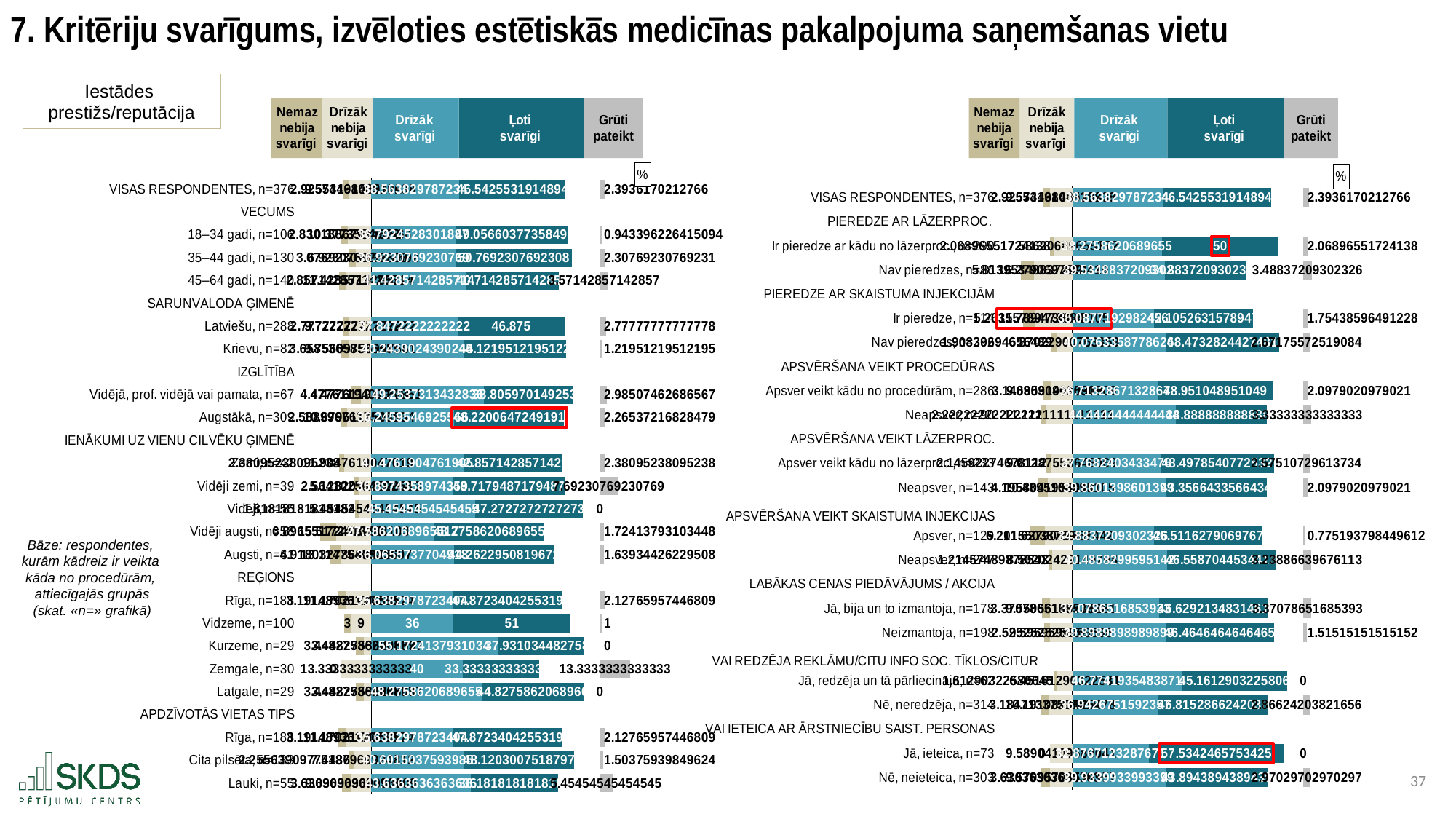
In the left chart, what is the value of 'Drīzāk svarīgi' for Vidzeme, n=100? 36 In the right chart, what is the highlighted 'Ļoti svarīgi' value for 'Jā, ieteica, n=73'? 57.5342465753425 In the right chart, what is the highlighted 'Ļoti svarīgi' value for 'Ir pieredze ar kādu no lāzerproc.'? 50 In the left chart, what is the difference between 'Ļoti svarīgi' and 'Drīzāk svarīgi' for Vidzeme, n=100? 15 In the left chart, which is larger for Vidzeme, n=100: 'Ļoti svarīgi' or 'Drīzāk svarīgi'? Ļoti svarīgi In the left chart, what is the value of 'Ļoti svarīgi' for Latviešu, n=288? 46.875 What kind of chart is used on the left side of the slide? bar chart In the left chart, what is the value of 'Ļoti svarīgi' for Vidzeme, n=100? 51 How many series does the legend above the left chart list? 5 In the left chart, what is the value of 'Grūti pateikt' for Vidzeme, n=100? 1 In the left chart, what is the highlighted 'Ļoti svarīgi' value for Augstākā, n=309? 48.2200647249191 What criterion is named in the box at the top left of the slide? Iestādes prestižs/reputācija